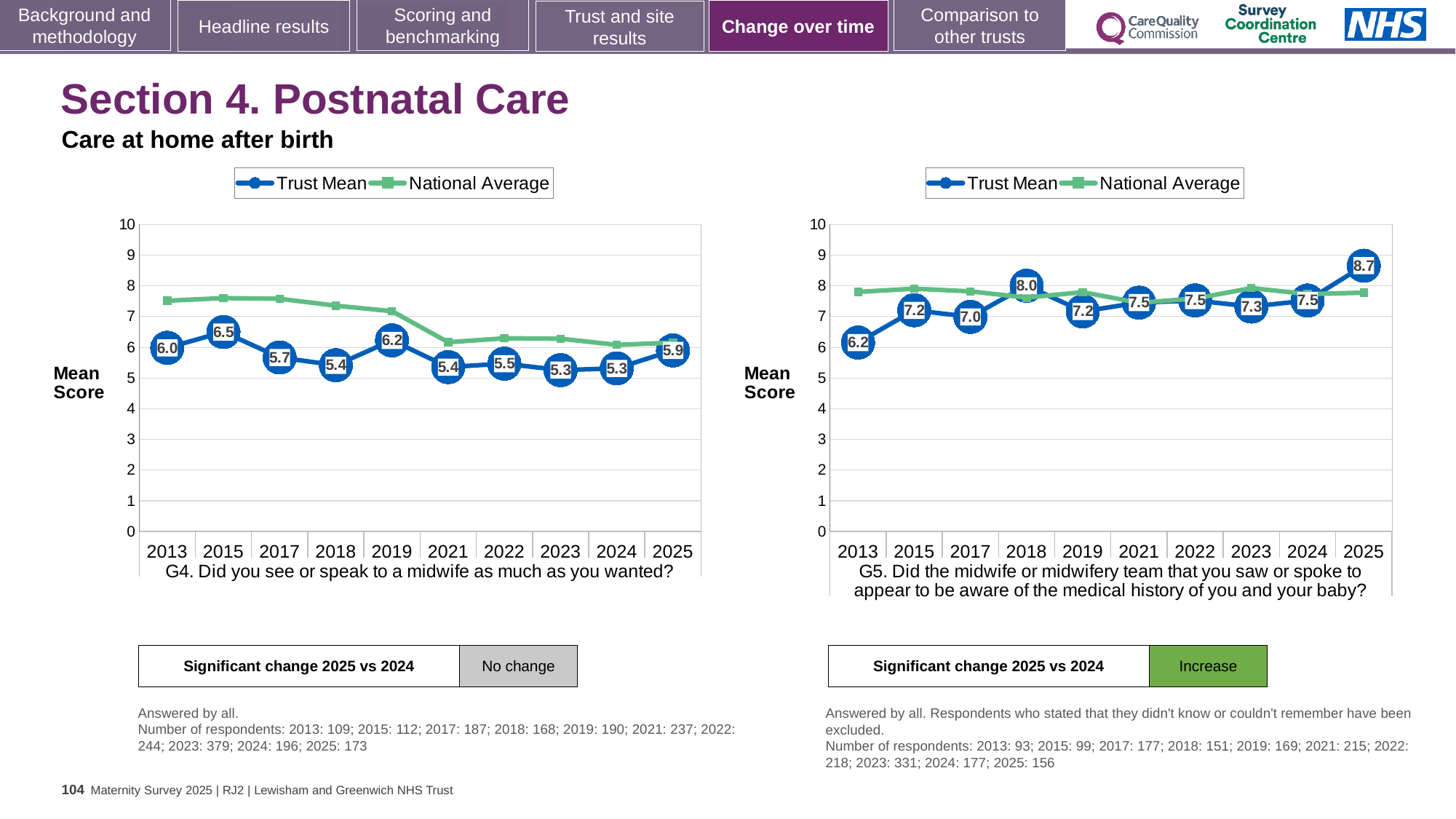
How many series does the legend of the G5 chart (right) list? 2 How many years are plotted on the x axis of the G4 chart (left)? 10 In the G5 chart (right), what is the difference between the Trust Mean scores for 2025 and 2024? 1.2 In the G4 chart (left), what is the Trust Mean score for 2025? 5.9 In the G4 chart (left), which year has the highest Trust Mean score? 2015 In the G5 chart (right), which year has the lowest Trust Mean score? 2013 In the G4 chart (left), is the National Average for 2013 greater or less than 7? greater In the G5 chart (right), is the National Average for 2025 greater or less than 8? less In the G5 chart (right), what is the Trust Mean score for 2018? 8.0 In the G4 chart (left), which is larger, the Trust Mean score for 2019 or for 2021? 2019 What type of chart is used for the G4 question (left)? Line chart In the G5 chart (right), what is the Trust Mean score for 2013? 6.2